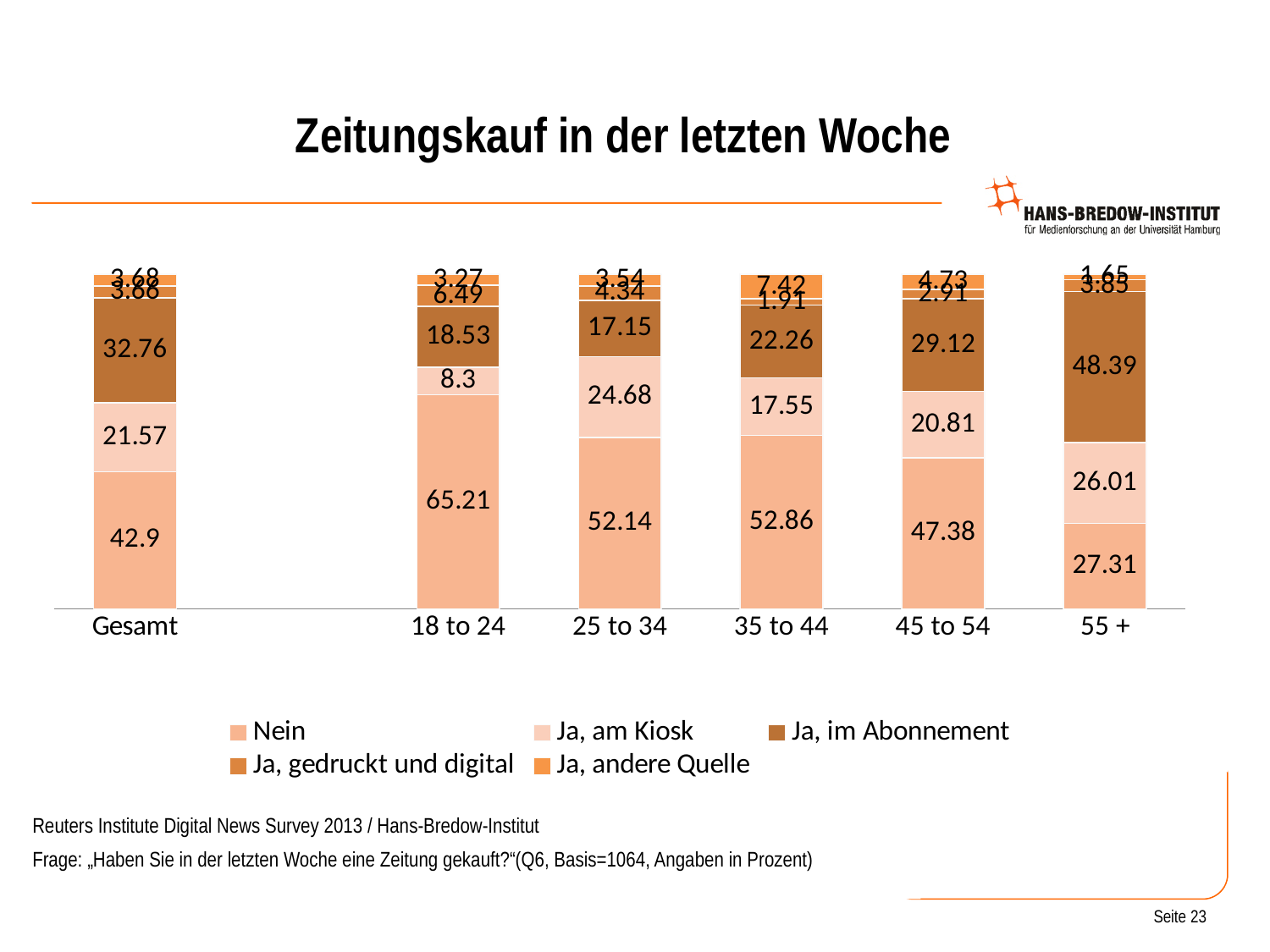
How many series does the legend list? 5 What is the value of the "Ja, im Abonnement" segment for the "55 +" age group? 48.39 What kind of chart is shown on the slide? Stacked bar chart What is the title of the chart? Zeitungskauf in der letzten Woche What is the value of the "Nein" segment for the "45 to 54" age group? 47.38 Which age group has the lowest "Ja, am Kiosk" value? 18 to 24 What is the difference between the "Nein" values for "18 to 24" and "55 +"? 37.9 What is the value of the "Nein" segment for the "18 to 24" age group? 65.21 How many age categories (including Gesamt) are shown on the x axis? 6 Which age group has the highest "Nein" value? 18 to 24 What is the value of the "Ja, am Kiosk" segment for "Gesamt"? 21.57 Which is larger: the "Ja, im Abonnement" value for "35 to 44" or for "45 to 54"? 45 to 54